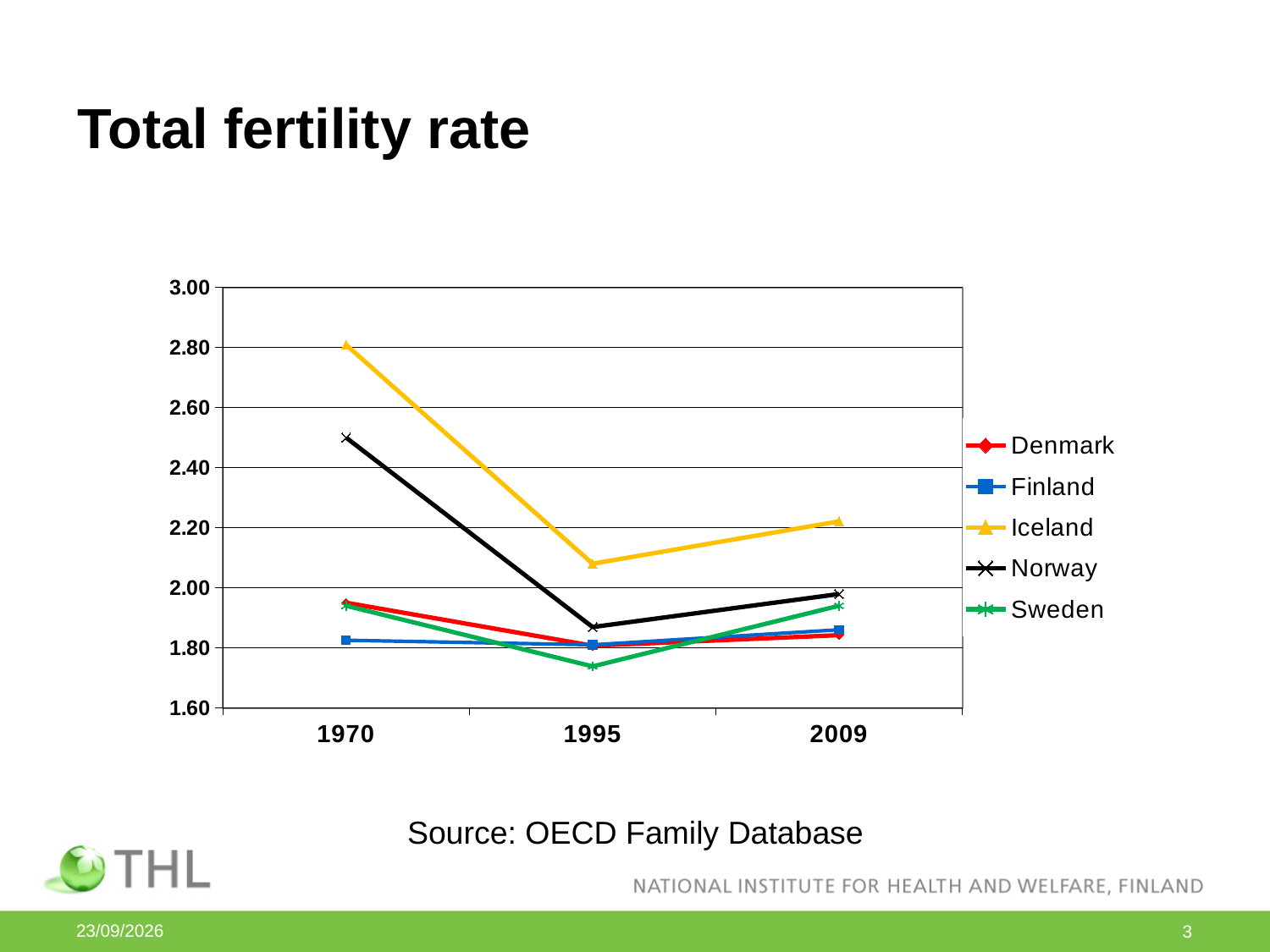
Which country had the highest total fertility rate in 1970? Iceland Is the value for Norway in 1995 greater or less than 2.00? less Is the value for Norway in 1970 greater or less than 2.40? greater Which is larger in 2009, the value for Iceland or the value for Norway? Iceland What is the title of the chart? Total fertility rate Which country had the highest total fertility rate in 2009? Iceland What kind of chart is shown on the slide? line chart Did the value for Iceland rise or fall between 1970 and 1995? fall Which country had the lowest total fertility rate in 1995? Sweden How many years are shown on the x axis? 3 How many series does the legend list? 5 Is the value for Iceland in 1970 greater or less than 2.60? greater